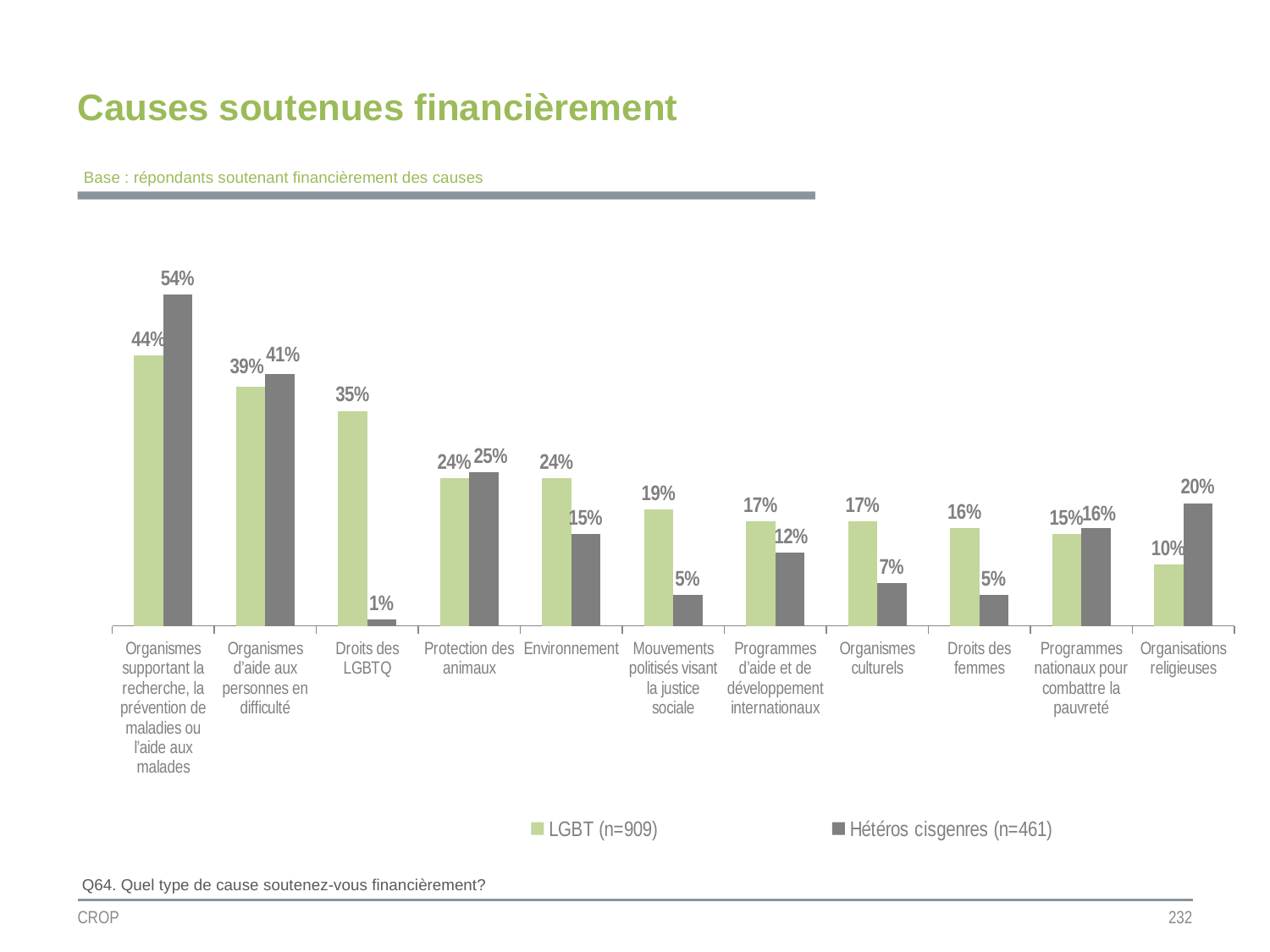
Which category has the highest value for Hétéros cisgenres (n=461)? Organismes supportant la recherche, la prévention de maladies ou l'aide aux malades What is the value for LGBT (n=909) for Droits des LGBTQ? 35% Which category has the lowest value for LGBT (n=909)? Organisations religieuses What is the value for Hétéros cisgenres (n=461) for Mouvements politisés visant la justice sociale? 5% What is the title of the chart on the slide? Causes soutenues financièrement For Environnement, which series has the larger value, LGBT (n=909) or Hétéros cisgenres (n=461)? LGBT (n=909) Which category has the lowest value for Hétéros cisgenres (n=461)? Droits des LGBTQ What kind of chart is shown on the slide? Bar chart What is the value for Hétéros cisgenres (n=461) for Organisations religieuses? 20% How many series does the legend list? 2 How many categories are shown on the x axis? 11 What is the difference between the LGBT (n=909) and Hétéros cisgenres (n=461) values for Droits des LGBTQ? 34 percentage points